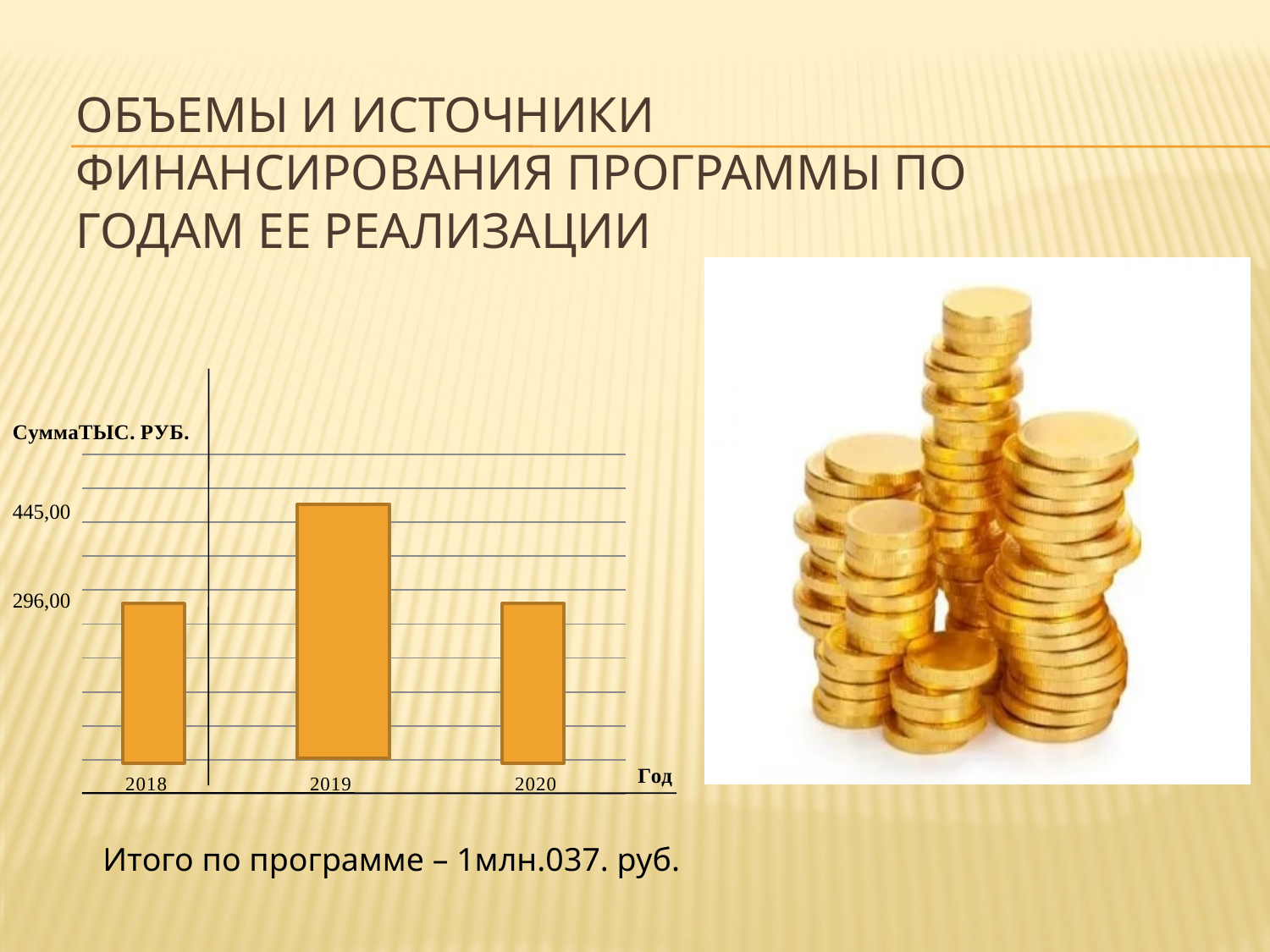
Which is larger, the value for 2019 or the value for 2020? 2019 How many years are plotted on the chart? 3 What kind of chart is shown on the slide? bar chart What is the label of the horizontal axis of the chart? Год What is the value for 2019 on the chart? 445,00 What is the label of the vertical axis of the chart? СуммаТЫС. РУБ. Is the value for 2020 greater or less than 445,00? less Which year has the highest value on the chart? 2019 What is the difference between the values for 2019 and 2018? 149,00 What is the value for 2020 on the chart? 296,00 Do the values rise or fall from 2019 to 2020? fall What is the value for 2018 on the chart? 296,00